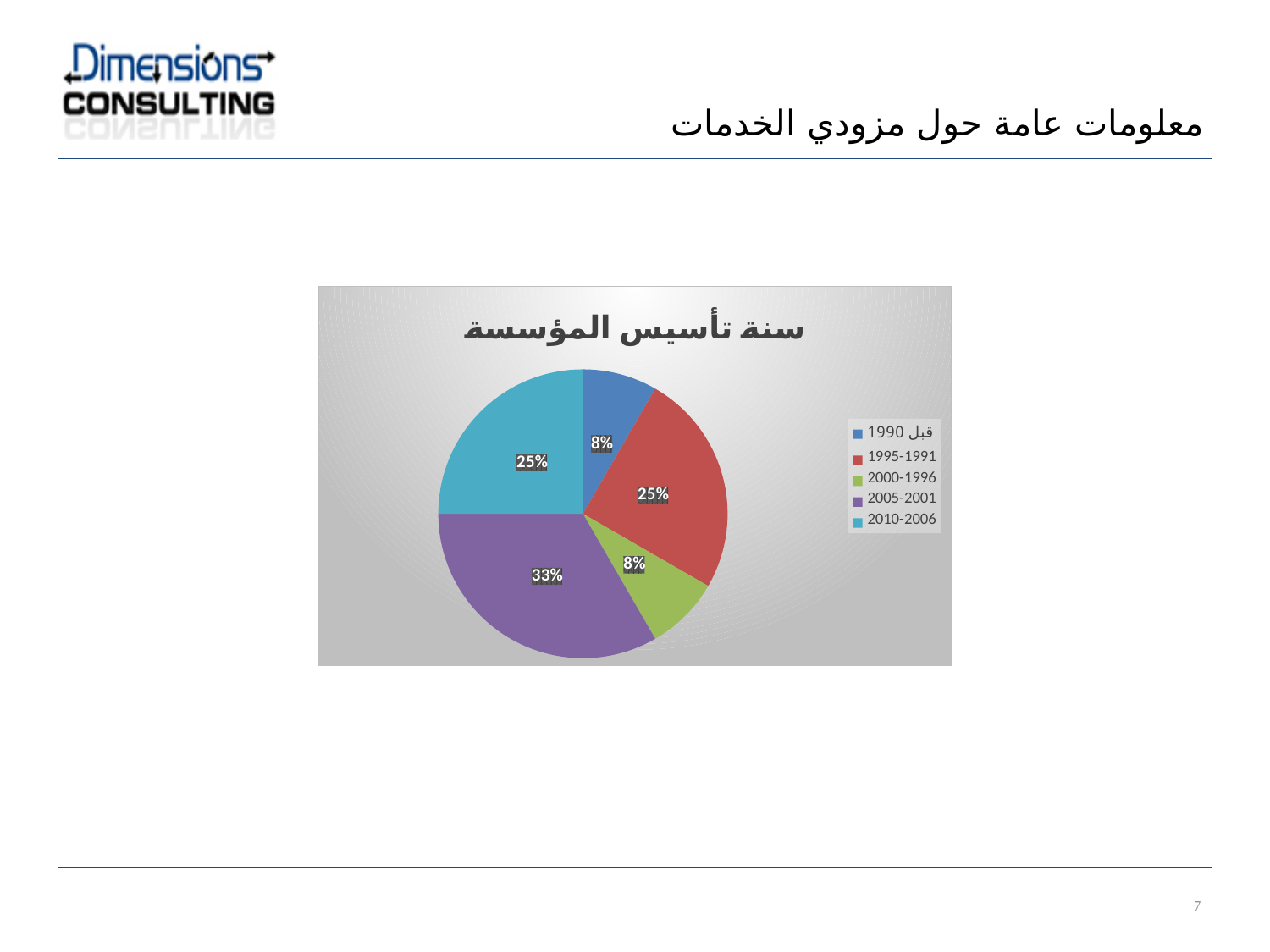
What kind of chart is shown on the slide? Pie chart What share of the pie does the category 2005-2001 represent? 33% Which category has the largest share of the pie? 2005-2001 What is the value shown for the category 2000-1996? 8% What is the title of the chart? سنة تأسيس المؤسسة What is the value shown for the category قبل 1990? 8% What is the difference between the share for 2005-2001 and the share for 2000-1996? 25% What is the value shown for the category 2010-2006? 25% Which is larger, the share for 1995-1991 or the share for قبل 1990? 1995-1991 What is the value shown for the category 1995-1991? 25% How many entries does the legend list? 5 How many slices does the pie chart have? 5